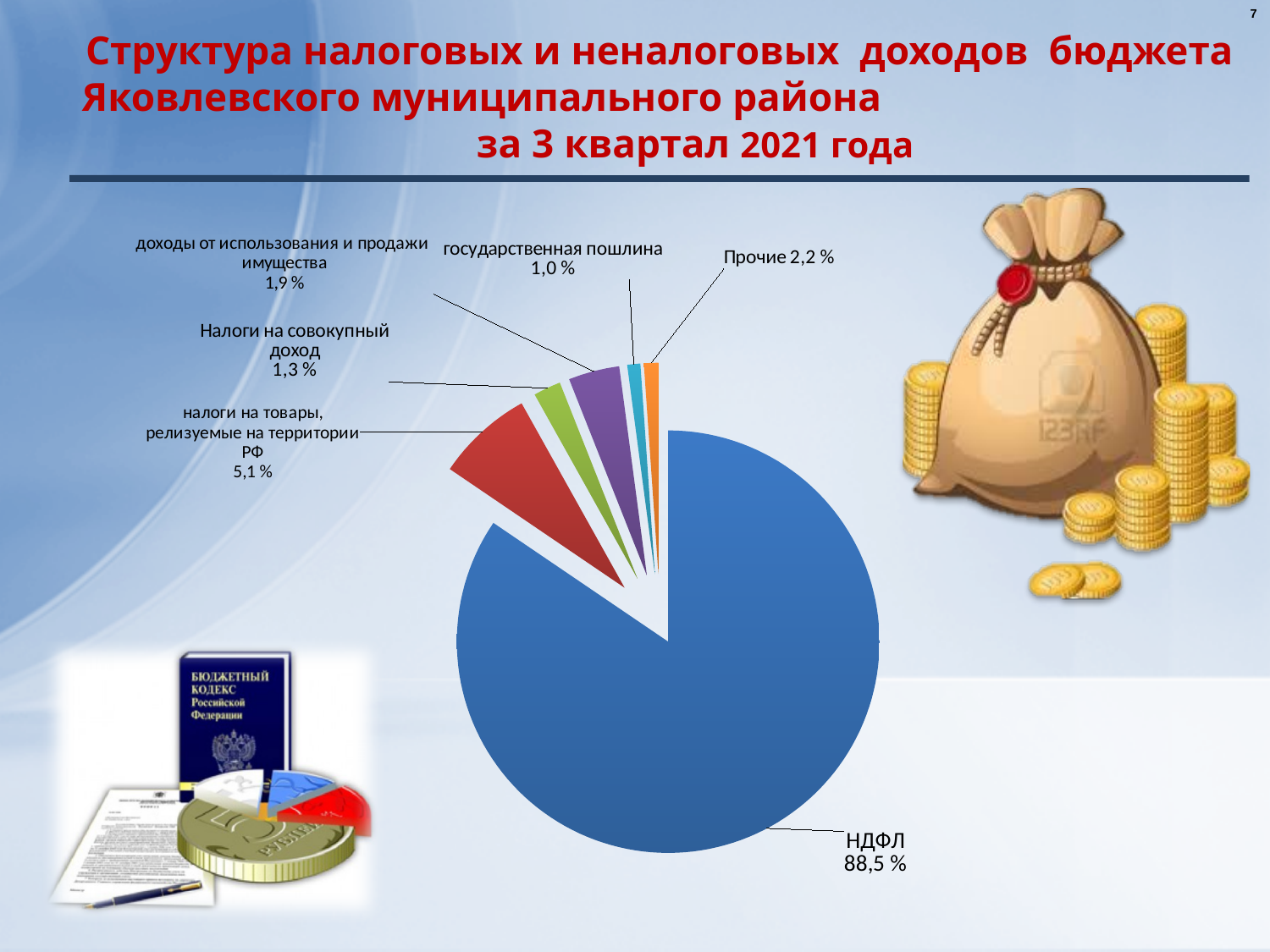
What share of the pie does НДФЛ account for? 88,5 % What kind of chart is shown on the slide? pie chart What is the value shown for Налоги на совокупный доход? 1,3 % Which category has the smallest share of the pie? государственная пошлина What is the value shown for налоги на товары, реализуемые на территории РФ? 5,1 % What is the value shown for Прочие? 2,2 % What is the value shown for государственная пошлина? 1,0 % Which category has the largest share of the pie? НДФЛ Which is larger: the share for Прочие or the share for доходы от использования и продажи имущества? Прочие How many slices does the pie chart have? 6 What is the difference between the share for НДФЛ and the share for налоги на товары, реализуемые на территории РФ? 83,4 % What is the value shown for доходы от использования и продажи имущества? 1,9 %